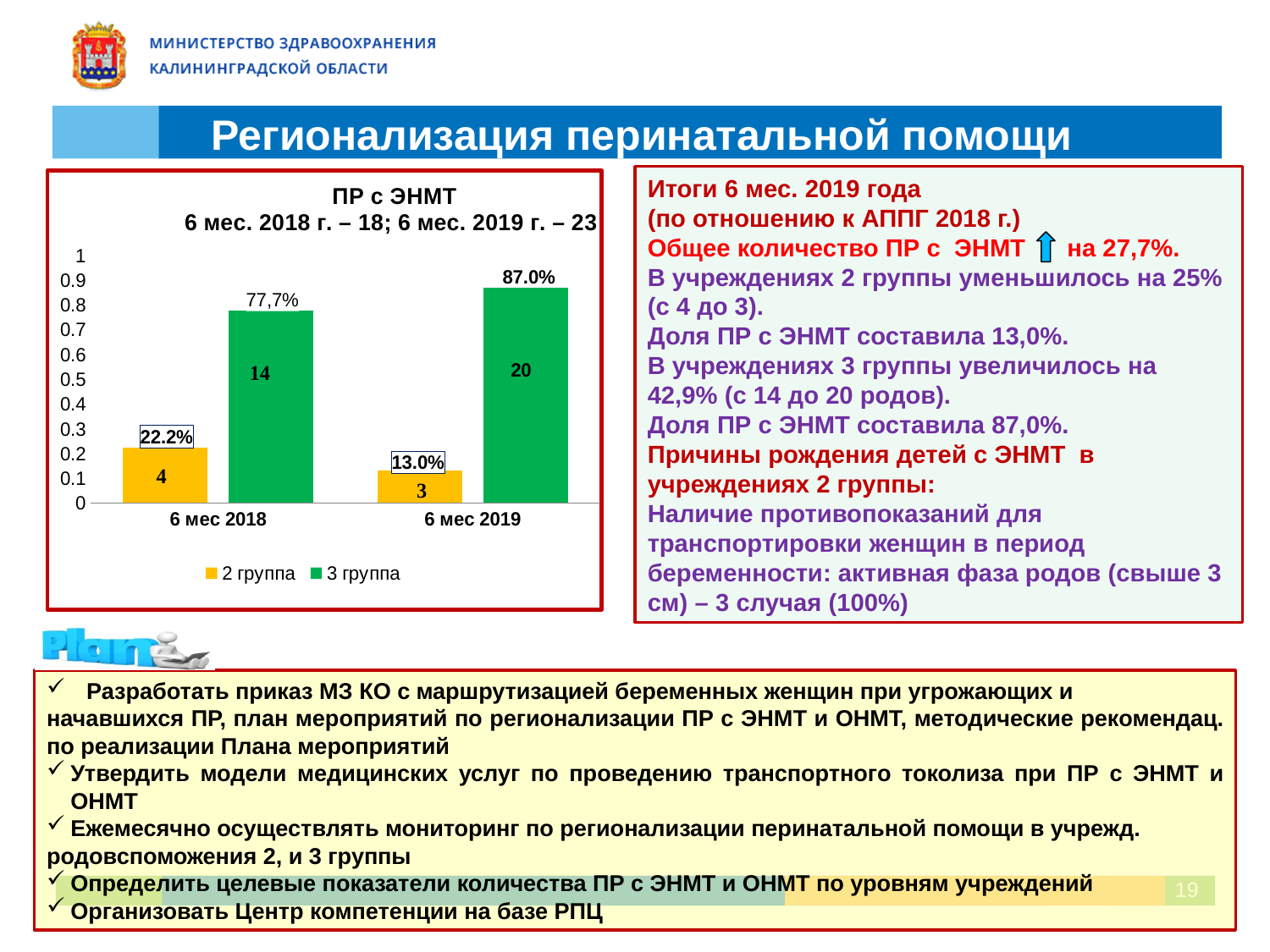
Which is larger: the 2 группа value for 6 мес 2018 or for 6 мес 2019? 6 мес 2018 What is the percentage label for 2 группа in 6 мес 2018? 22.2% How many series does the legend list? 2 What colour represents 3 группа in the chart? green What number is printed inside the 3 группа bar for 6 мес 2019? 20 What is the percentage label for 2 группа in 6 мес 2019? 13.0% Which bar has the lowest percentage value in the chart? 2 группа, 6 мес 2019 What type of chart is shown on the slide? bar chart What is the percentage label for 3 группа in 6 мес 2018? 77,7% What is the percentage label for 3 группа in 6 мес 2019? 87.0% What number is printed inside the 2 группа bar for 6 мес 2018? 4 Which bar has the highest percentage value in the chart? 3 группа, 6 мес 2019